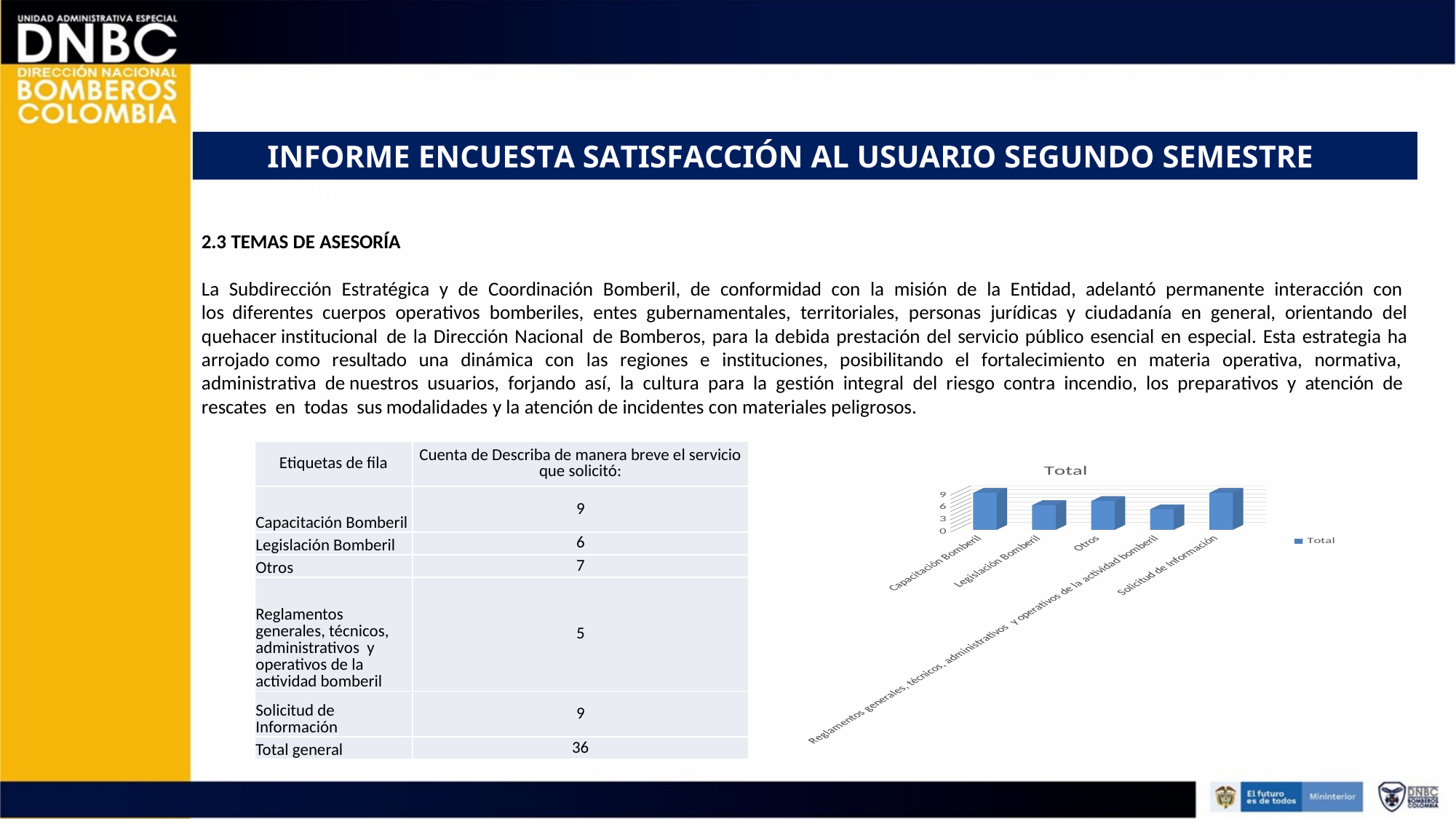
According to the table accompanying the chart, what is the value for Otros? 7 Is the value for Legislación Bomberil in the chart greater or less than 9? less How many categories are plotted on the chart's x axis? 5 Is the value for Capacitación Bomberil in the chart greater or less than 6? greater What is the title of the chart? Total How many series does the chart's legend list? 1 What kind of chart is shown on the slide? bar chart Which is larger in the chart, the value for Solicitud de Información or the value for Legislación Bomberil? Solicitud de Información According to the table accompanying the chart, what is the difference between the value for Capacitación Bomberil and the value for Reglamentos generales, técnicos, administrativos y operativos de la actividad bomberil? 4 According to the table accompanying the chart, what is the value for Solicitud de Información? 9 What is the name of the series shown in the chart's legend? Total Which is larger in the chart, the value for Capacitación Bomberil or the value for Reglamentos generales, técnicos, administrativos y operativos de la actividad bomberil? Capacitación Bomberil